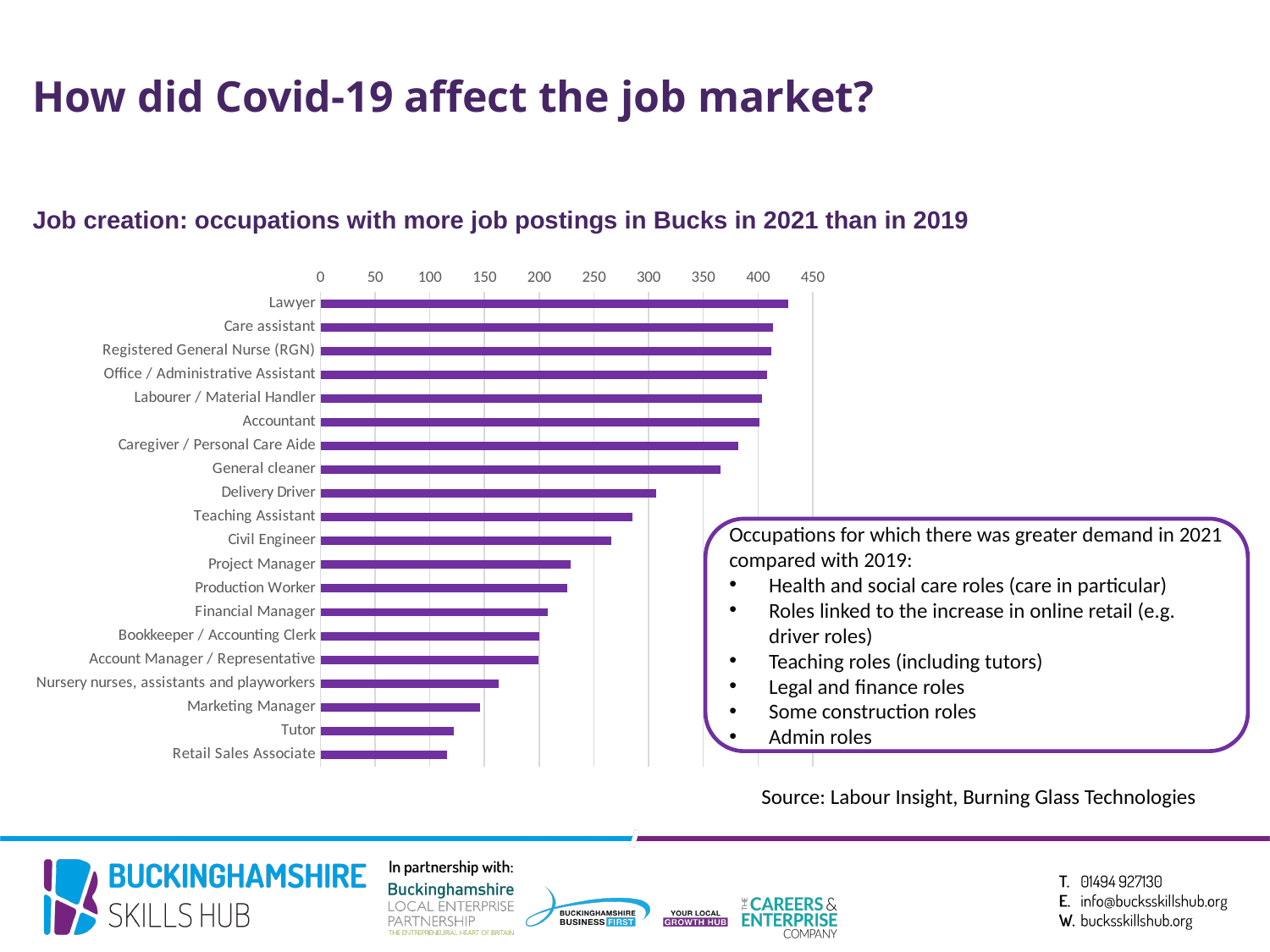
Is the value for Caregiver / Personal Care Aide greater or less than 350? greater Is the value for Tutor greater or less than 150? less What is the title of the chart? Job creation: occupations with more job postings in Bucks in 2021 than in 2019 How many occupations are plotted in the chart? 20 Which occupation has the highest number of job postings in the chart? Lawyer What kind of chart is shown on the slide? Bar chart Which has a larger value, Care assistant or General cleaner? Care assistant Is the value for Lawyer greater or less than 400? greater Which has a larger value, Delivery Driver or Civil Engineer? Delivery Driver